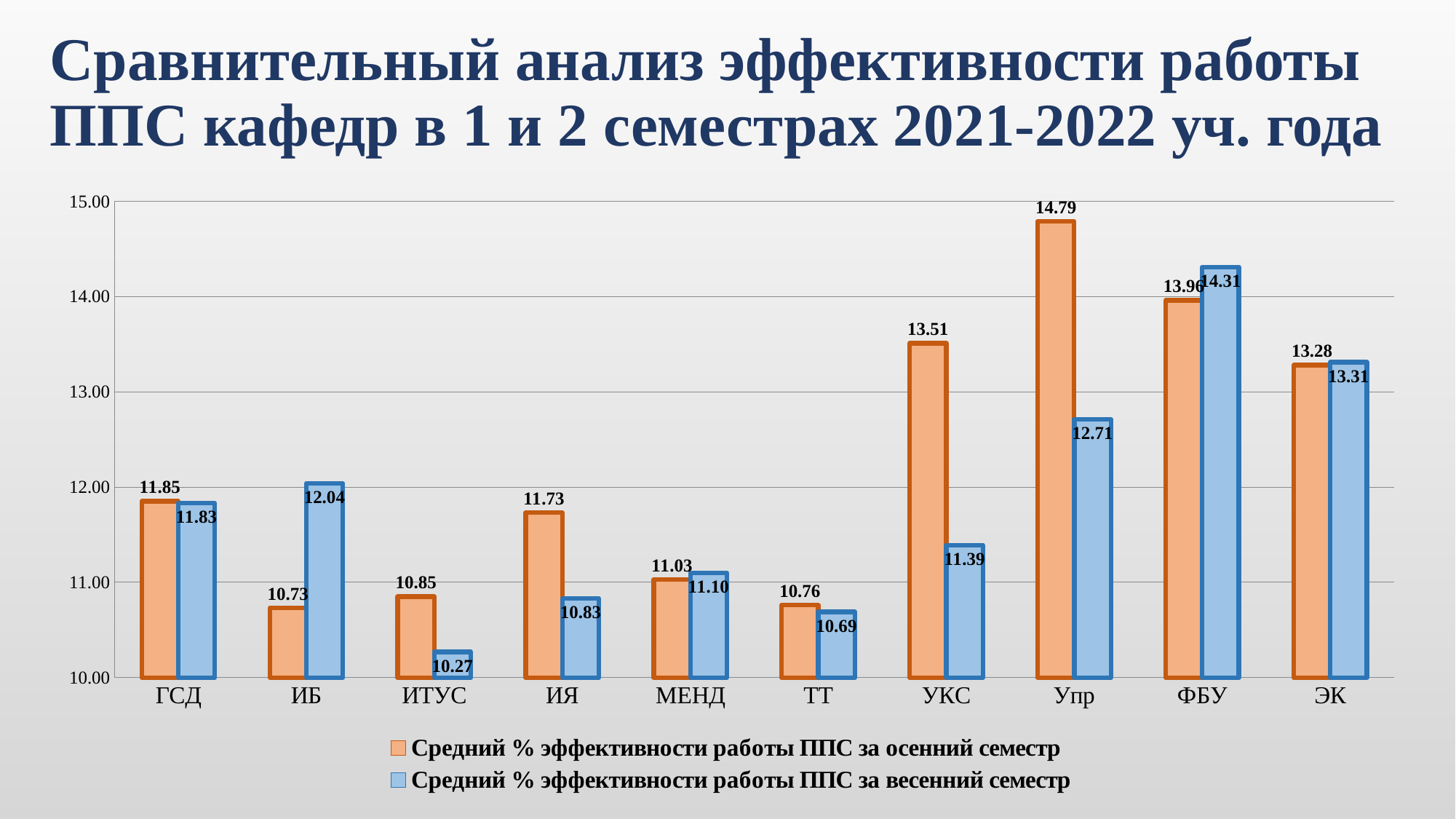
What kind of chart is shown on the slide? bar chart What is the value for ИБ in the series 'Средний % эффективности работы ППС за весенний семестр'? 12.04 What is the value for ТТ in the series 'Средний % эффективности работы ППС за весенний семестр'? 10.69 How many categories (departments) are shown on the x axis? 10 Which colour represents the series 'Средний % эффективности работы ППС за весенний семестр'? blue Is the value for ЭК in the series 'Средний % эффективности работы ППС за осенний семестр' greater or less than 13.00? greater Which category has the lowest value in the series 'Средний % эффективности работы ППС за весенний семестр'? ИТУС What is the difference between the autumn semester value (осенний семестр) and the spring semester value (весенний семестр) for УКС? 2.12 What is the value for Упр in the series 'Средний % эффективности работы ППС за осенний семестр'? 14.79 How many series does the legend list? 2 For ФБУ, which is larger: the autumn semester value (осенний семестр) or the spring semester value (весенний семестр)? весенний семестр (14.31) Which category has the highest value in the series 'Средний % эффективности работы ППС за осенний семестр'? Упр